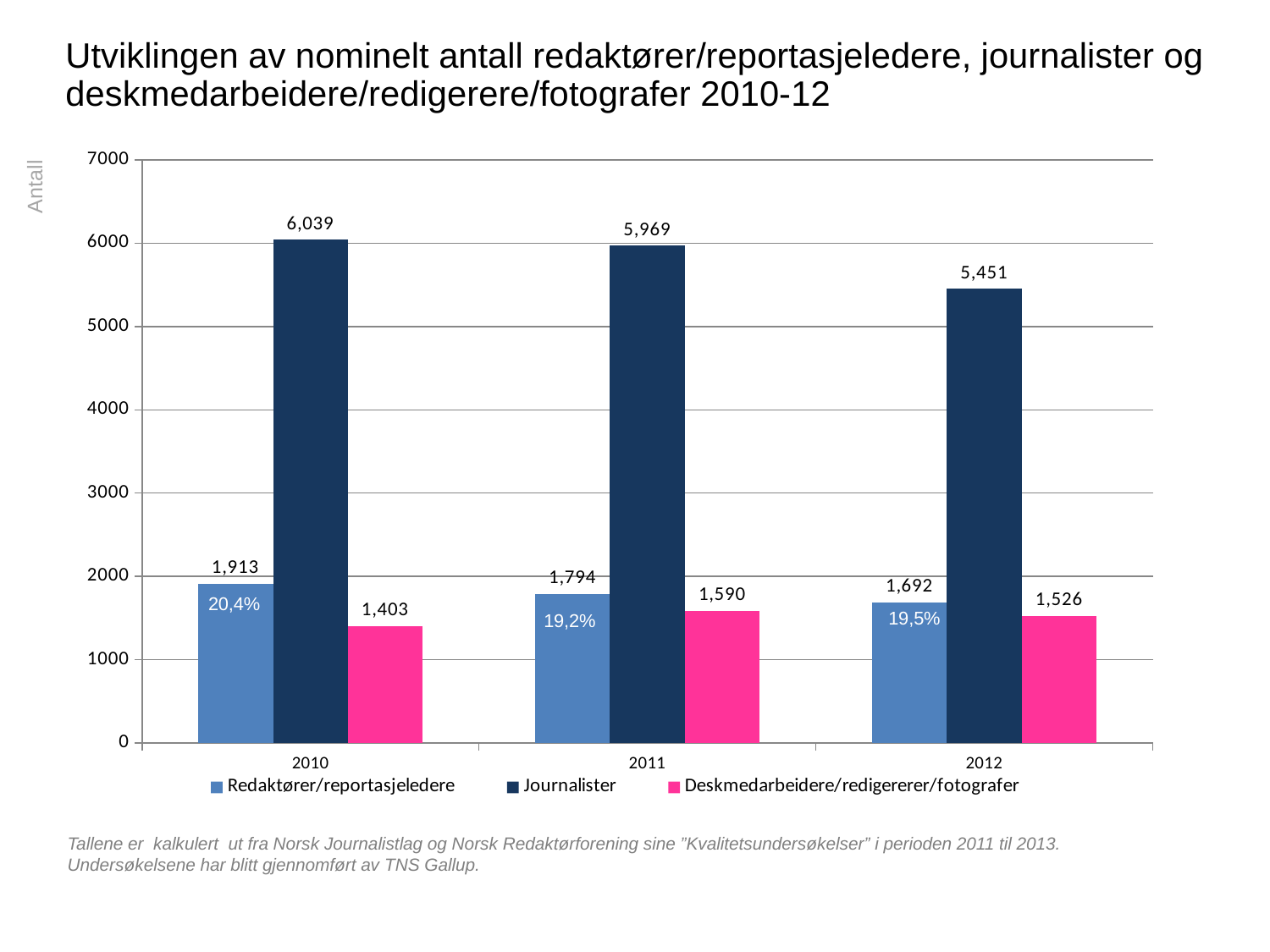
How many years are shown on the x axis? 3 Which is larger in 2012: Redaktører/reportasjeledere or Deskmedarbeidere/redigererer/fotografer? Redaktører/reportasjeledere In which year is the Deskmedarbeidere/redigererer/fotografer value lowest? 2010 Do the Journalister values rise or fall from 2010 to 2012? fall What kind of chart is shown on the slide? bar chart What percentage is shown inside the Redaktører/reportasjeledere bar for 2010? 20,4% What is the value for Journalister in 2010? 6,039 In which year is the Journalister value highest? 2010 What is the value for Redaktører/reportasjeledere in 2012? 1,692 What is the value for Deskmedarbeidere/redigererer/fotografer in 2011? 1,590 What is the difference between the Journalister values for 2010 and 2012? 588 How many series does the legend list? 3